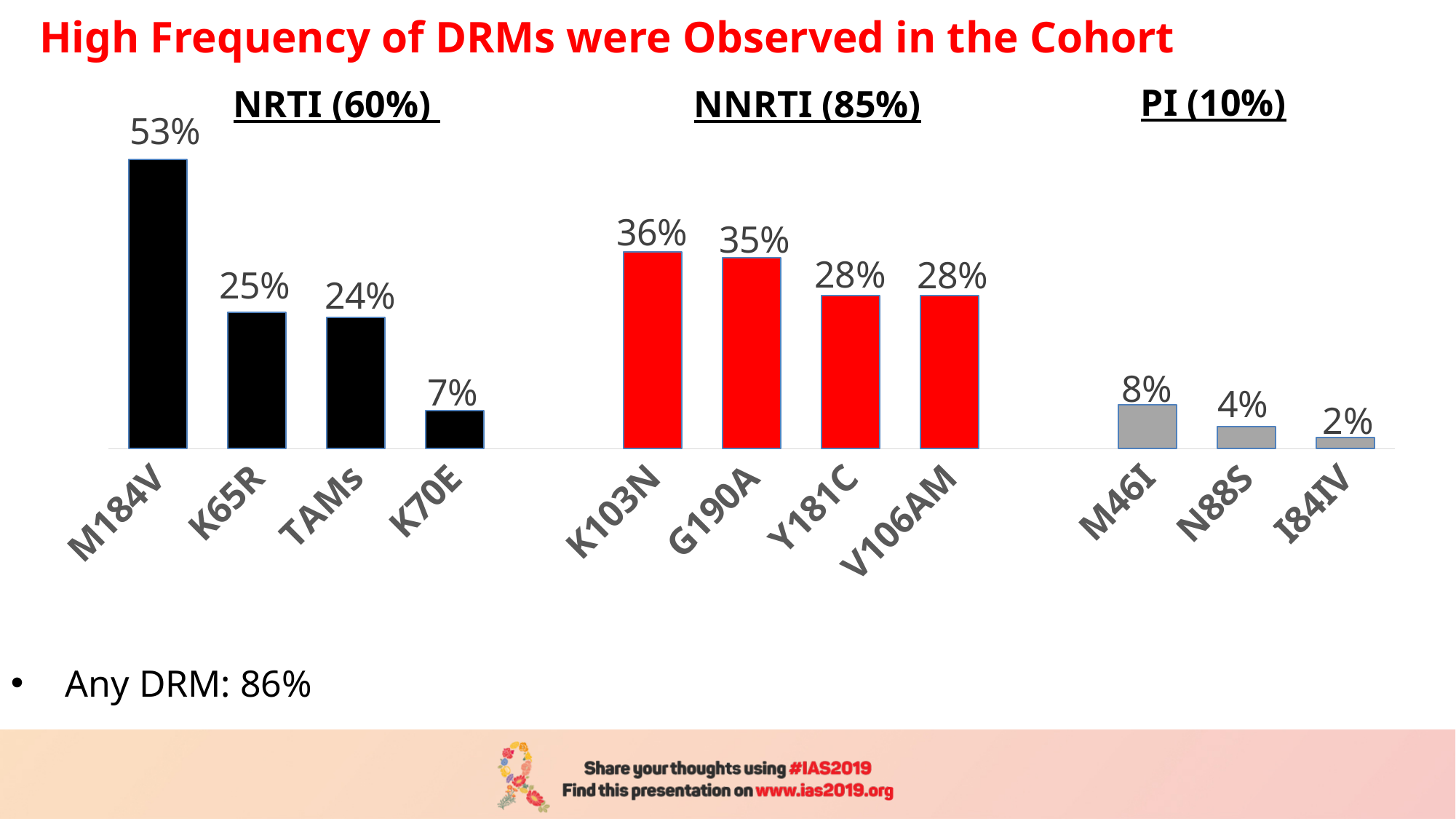
How many DRM categories are plotted on the chart? 11 What is the value for K103N? 36% Which DRM has the highest frequency on the chart? M184V What is the difference between the values for K103N and Y181C? 8% Which is larger, the value for TAMs or the value for K70E? TAMs What is the value for N88S? 4% What kind of chart is shown on the slide? Bar chart What is the difference between the values for M184V and K65R? 28% Which DRM has the lowest frequency on the chart? I84IV What colour are the bars in the NNRTI group? Red Which is larger, the value for M46I or the value for Y181C? Y181C What is the value for M184V? 53%